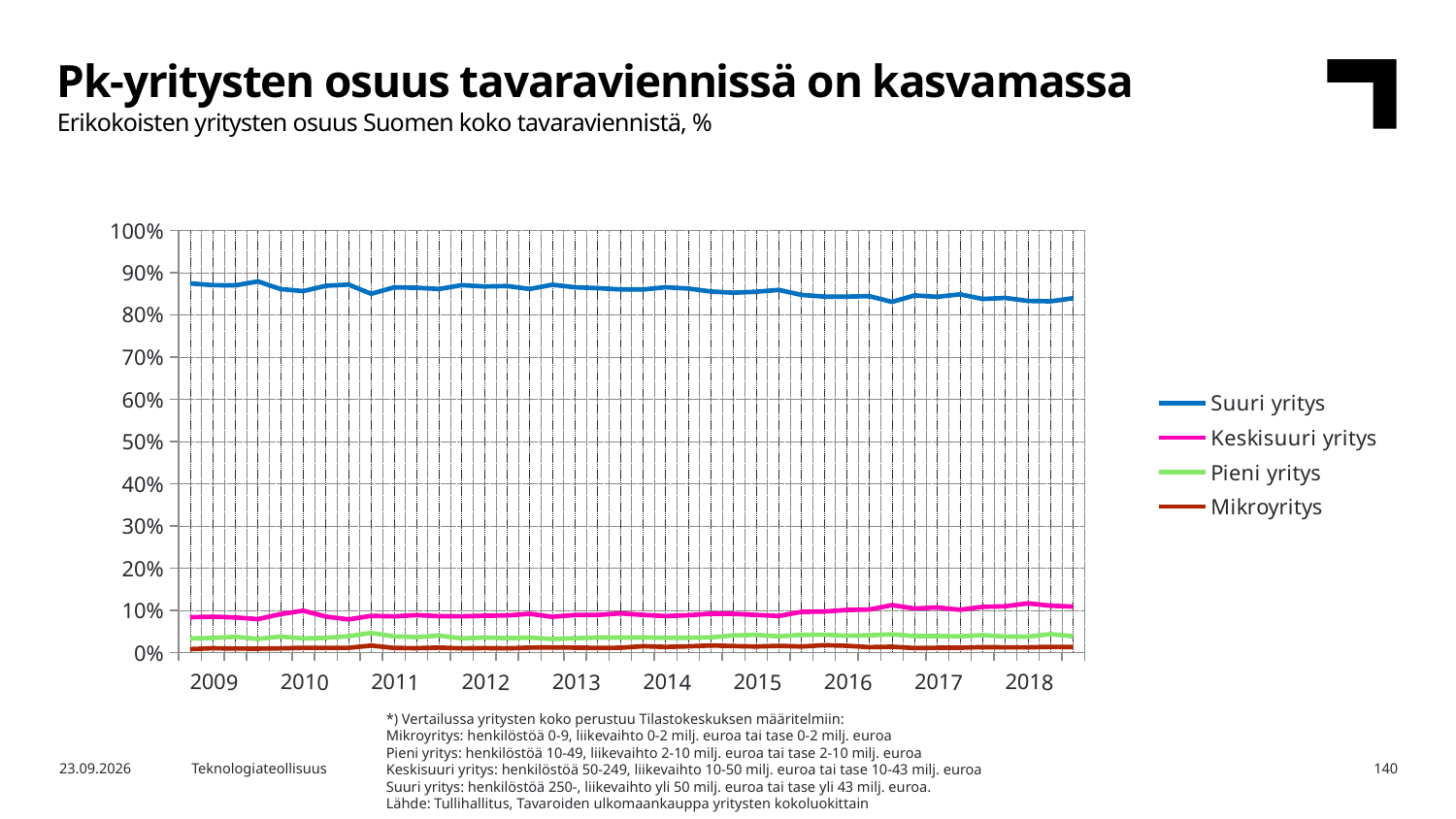
How many years are labelled on the x axis? 10 Is the value for Keskisuuri yritys in 2018 greater or less than 20%? less Is the value for Suuri yritys in 2009 greater or less than 80%? greater Which is larger in 2015, the share of Suuri yritys or Keskisuuri yritys? Suuri yritys How many series does the legend list? 4 Is the value for Pieni yritys in 2012 greater or less than 10%? less Which series has the highest share throughout the period? Suuri yritys What colour is the line for Suuri yritys? Blue Does the share of Suuri yritys rise or fall from 2009 to 2018? Fall What kind of chart is shown on the slide? Line chart Does the share of Keskisuuri yritys rise or fall from 2009 to 2018? Rise Which series has the lowest share throughout the period? Mikroyritys